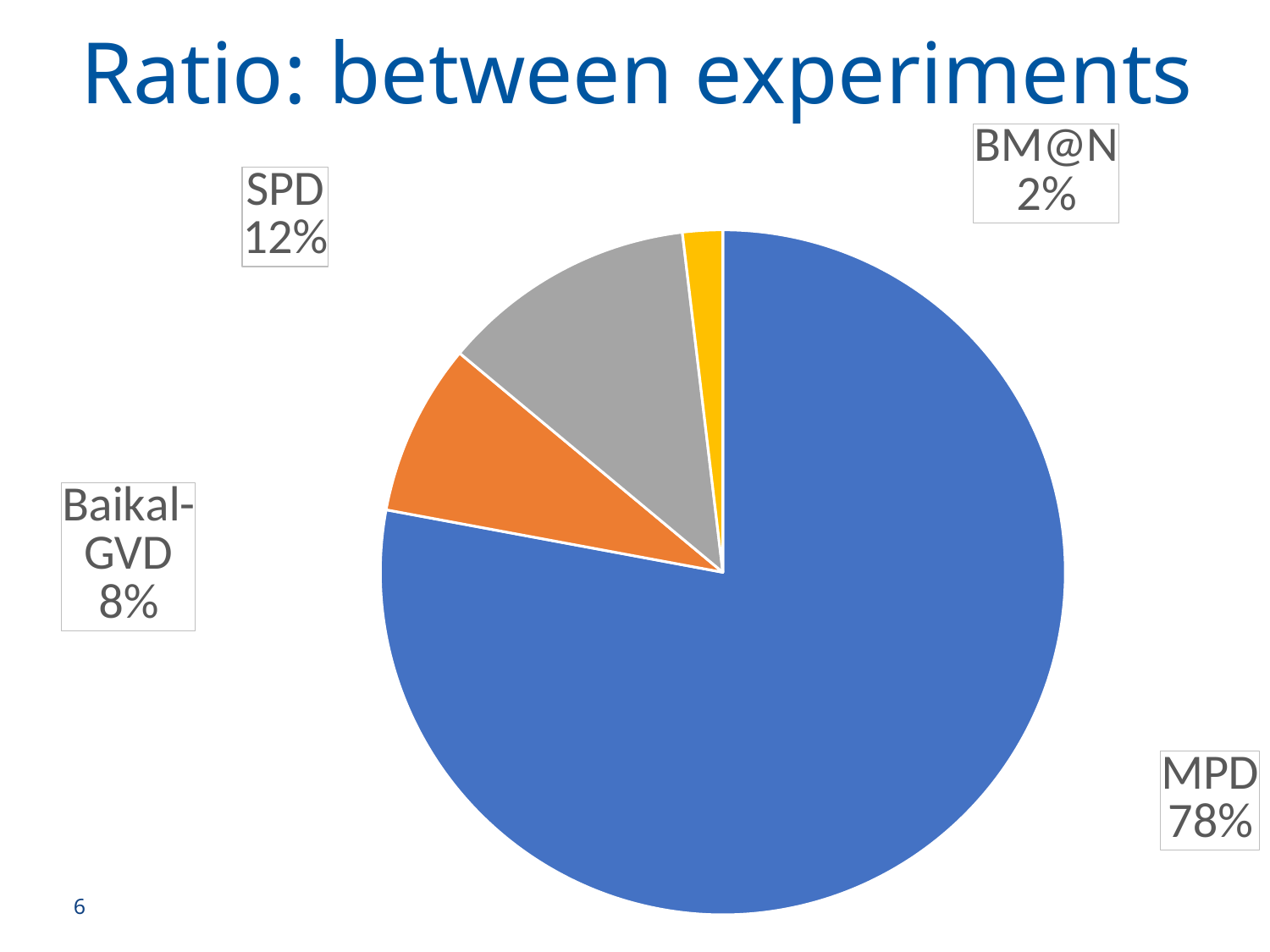
What is the difference in percentage points between the MPD and SPD shares? 66 What is the title of the chart? Ratio: between experiments What share of the pie does BM@N have? 2% How many experiments are shown in the pie chart? 4 What kind of chart is shown on the slide? Pie chart What share of the pie does Baikal-GVD have? 8% What share of the pie does MPD have? 78% Which has a larger share, SPD or Baikal-GVD? SPD Which experiment has the largest slice of the pie? MPD Which experiment has the smallest slice of the pie? BM@N What is the difference in percentage points between the SPD and Baikal-GVD shares? 4